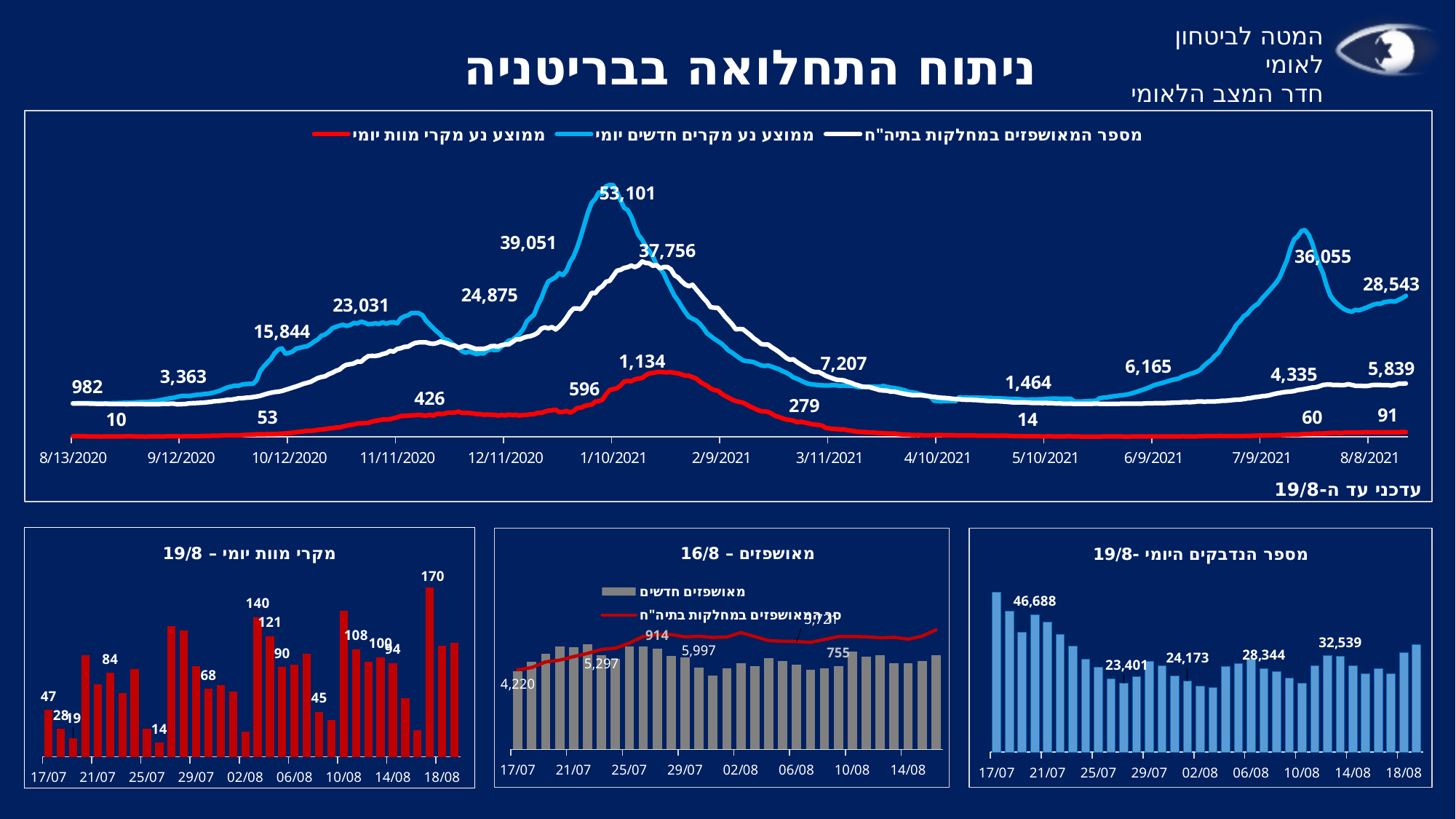
In the top line chart, what is the highest value labelled on the white hospitalized-in-wards line? 37,756 In the top line chart, what is the last labelled value on the white hospitalized line, at the right end? 5,839 In the top line chart, what is the peak value labelled on the blue daily new cases moving-average line? 53,101 In the top line chart, what is the last labelled value on the blue daily new cases line, at the right end? 28,543 In the top line chart, what is the difference between the blue line's labelled values 36,055 and 28,543? 7,512 In the bottom-right daily infections bar chart, what is the highest labelled value? 46,688 In the bottom-middle hospitalized chart, what is the first labelled value on the red line at the left? 4,220 In the bottom-left daily deaths bar chart, what is the lowest labelled value? 14 How many series does the legend of the top line chart list? 3 What type of chart is the top chart on the slide? Line chart